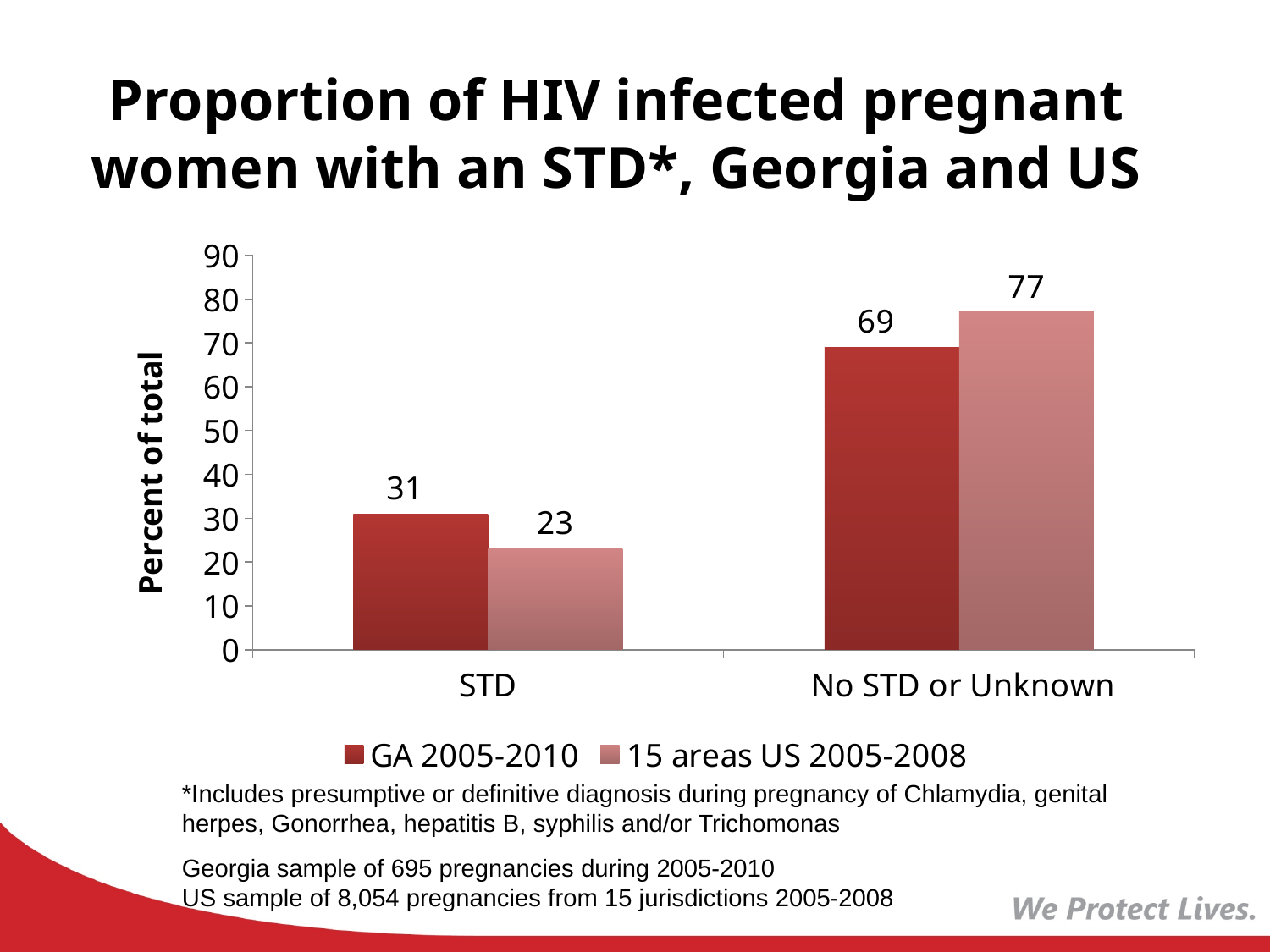
How many series does the legend list? 2 What is the label of the y axis? Percent of total What kind of chart is shown on the slide? Bar chart What is the value for 15 areas US 2005-2008 in the STD category? 23 Which series has the higher value in the No STD or Unknown category? 15 areas US 2005-2008 What is the value for GA 2005-2010 in the STD category? 31 What is the value for GA 2005-2010 in the No STD or Unknown category? 69 Which series has the higher value in the STD category? GA 2005-2010 What is the difference between the 15 areas US 2005-2008 and GA 2005-2010 values in the No STD or Unknown category? 8 What is the difference between the GA 2005-2010 and 15 areas US 2005-2008 values in the STD category? 8 How many categories are shown on the x axis? 2 What is the value for 15 areas US 2005-2008 in the No STD or Unknown category? 77